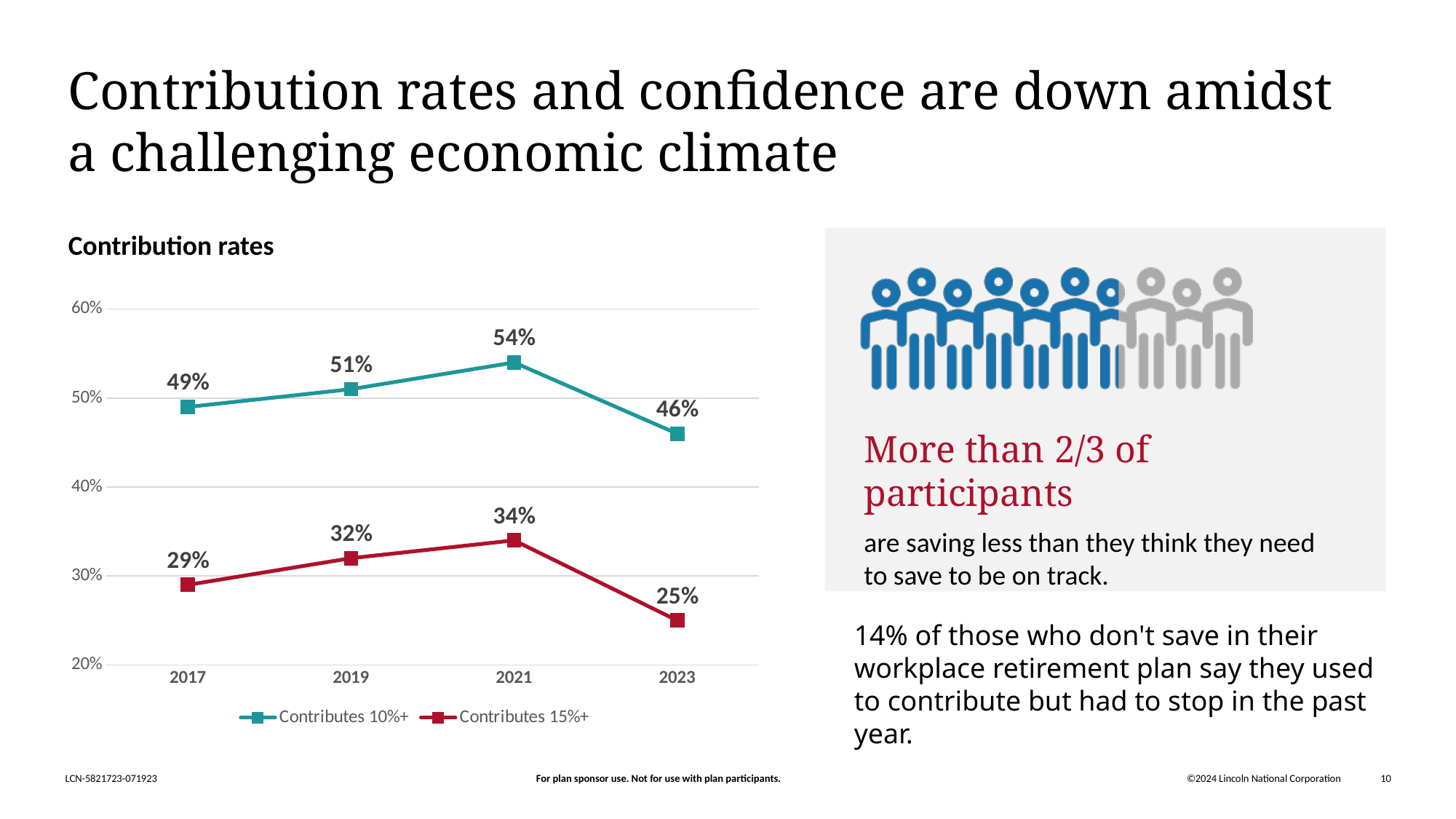
Which is larger: Contributes 10%+ in 2017 or Contributes 10%+ in 2019? Contributes 10%+ in 2019 How many years are shown on the x axis? 4 What is the difference between Contributes 10%+ and Contributes 15%+ in 2023? 21% By how much did the Contributes 15%+ value fall from 2021 to 2023? 9% What is the title of the chart? Contribution rates What kind of chart is shown? Line chart What is the value for Contributes 10%+ in 2021? 54% What is the value for Contributes 15%+ in 2023? 25% In which year is the Contributes 15%+ series lowest? 2023 What is the value for Contributes 15%+ in 2017? 29% How many series does the legend list? 2 In which year is the Contributes 10%+ series highest? 2021